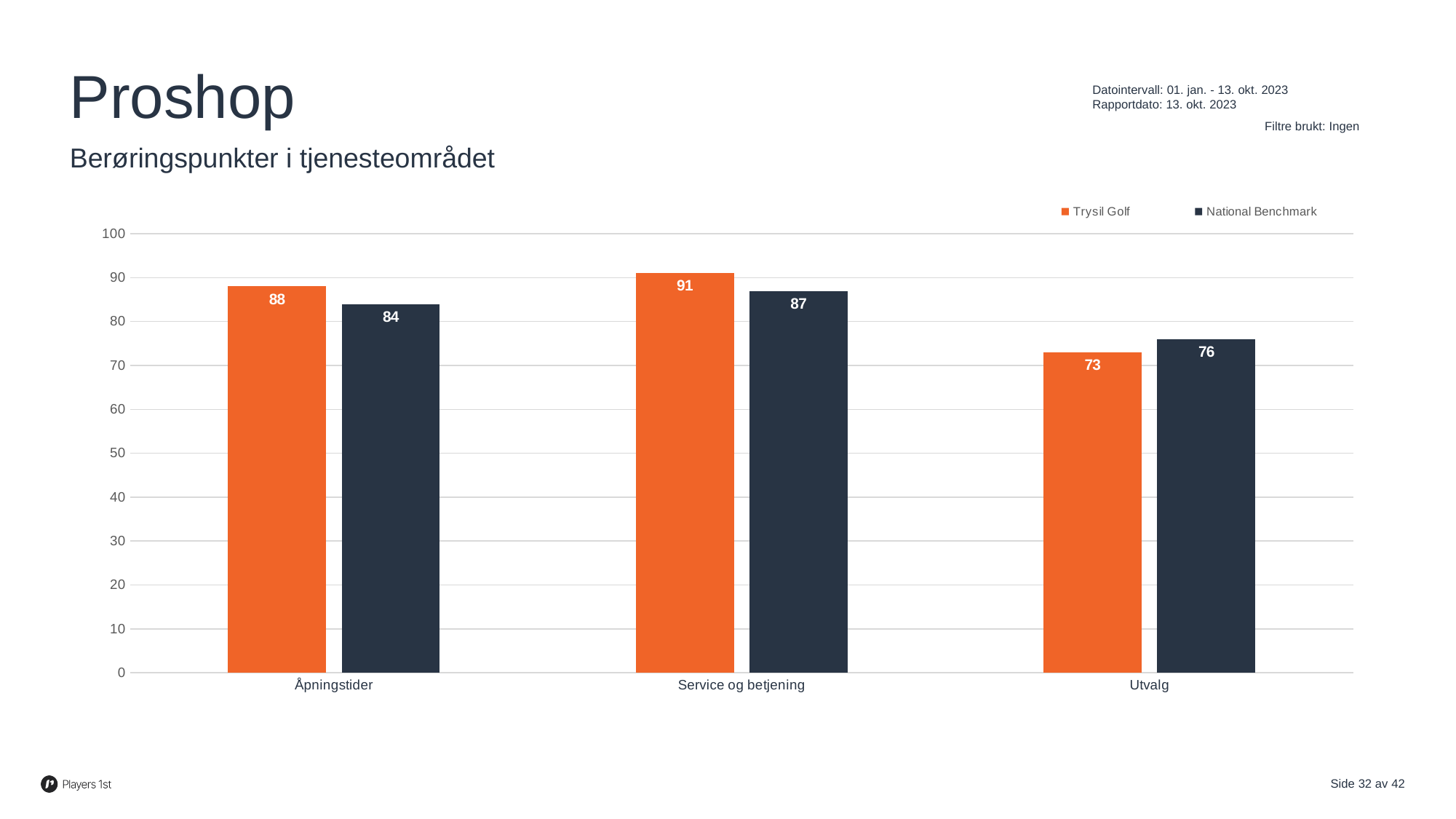
What kind of chart is shown on the slide? bar chart Which category has the highest Trysil Golf value? Service og betjening Which category has the lowest National Benchmark value? Utvalg How many series does the legend list? 2 For Utvalg, which is larger: Trysil Golf or National Benchmark? National Benchmark What colour are the Trysil Golf bars? orange What is the Trysil Golf value for Utvalg? 73 What is the difference between the Trysil Golf and National Benchmark values for Åpningstider? 4 Is the National Benchmark value for Utvalg greater or less than 80? less What is the National Benchmark value for Service og betjening? 87 How many categories are shown on the x axis? 3 What is the Trysil Golf value for Åpningstider? 88